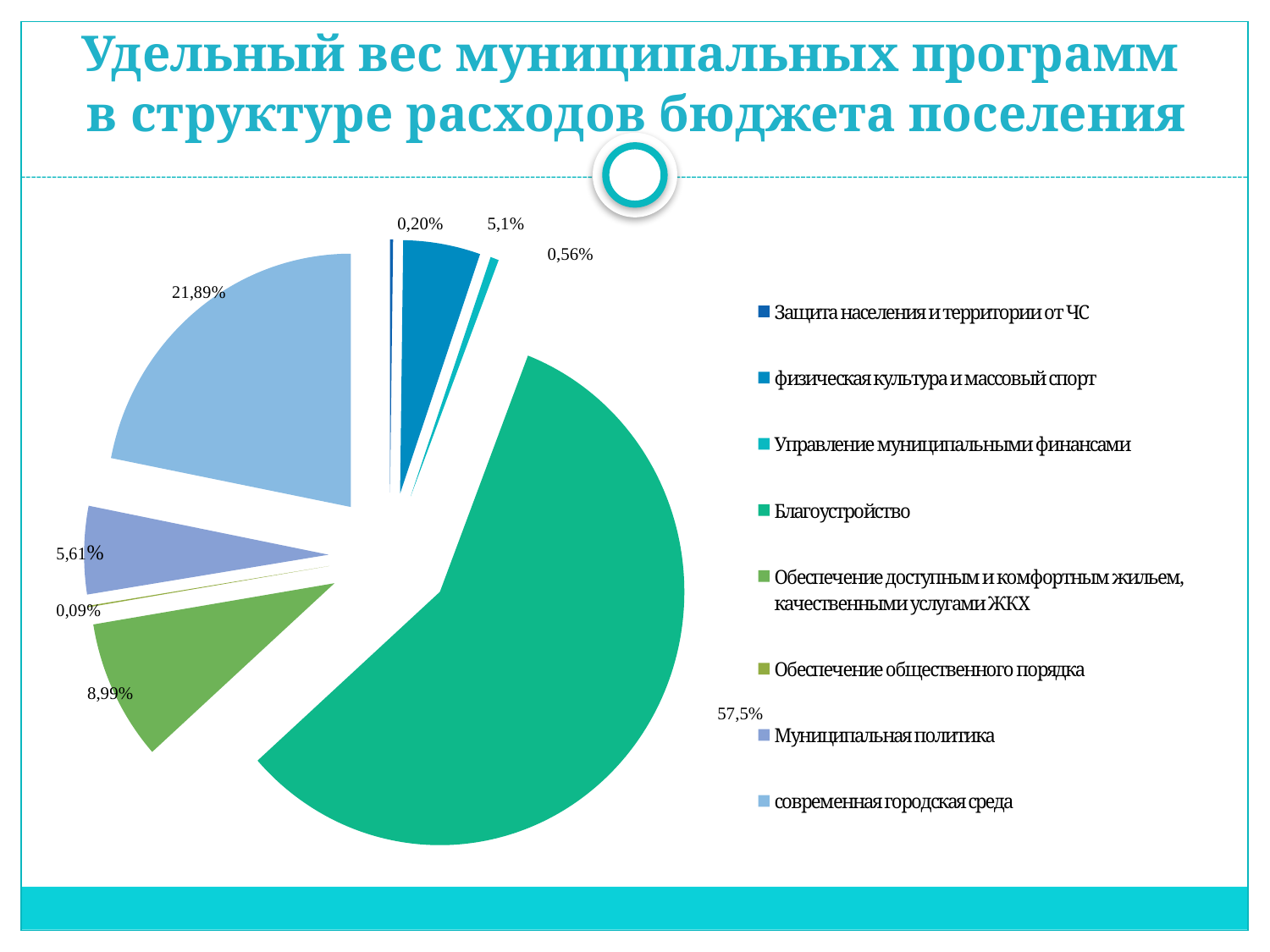
What is the share for Благоустройство? 57,5% How many slices does the pie chart have? 8 What is the share for Муниципальная политика? 5,61% Which has a larger share: Обеспечение доступным и комфортным жильем, качественными услугами ЖКХ or Муниципальная политика? Обеспечение доступным и комфортным жильем, качественными услугами ЖКХ What is the difference between the shares for Благоустройство and современная городская среда? 35,61% What is the share for Обеспечение общественного порядка? 0,09% What kind of chart is shown on the slide? pie chart What is the share for современная городская среда? 21,89% How many entries does the legend list? 8 Which category has the smallest share of the pie? Обеспечение общественного порядка Which category has the largest share of the pie? Благоустройство What is the share for физическая культура и массовый спорт? 5,1%